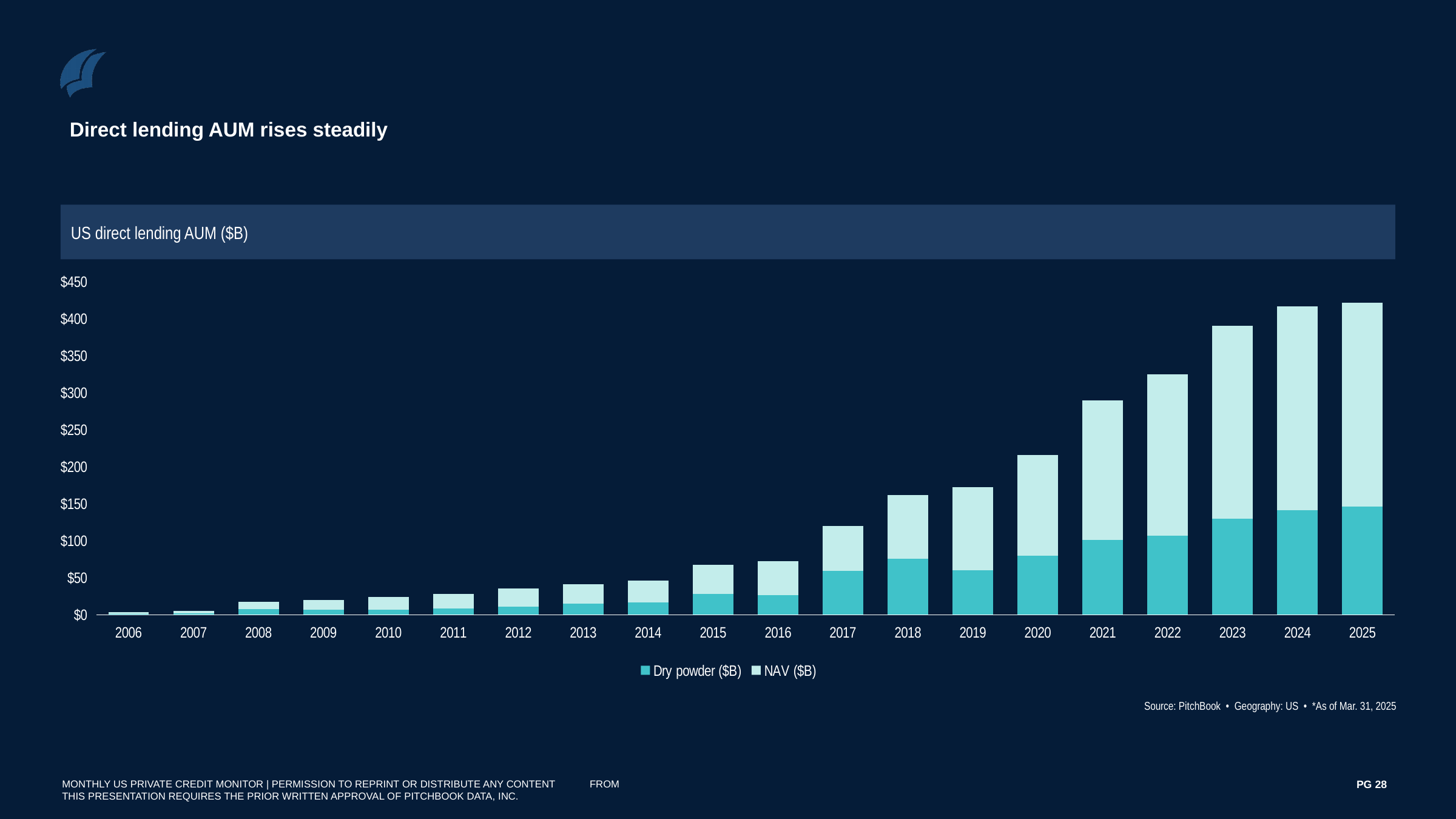
Is the total AUM for 2025 greater or less than $400? greater What are the two series named in the legend? Dry powder ($B) and NAV ($B) Which year has the highest total US direct lending AUM? 2025 How many series does the legend list? 2 Is the total AUM for 2020 greater or less than $200? greater Which year has a larger total AUM, 2019 or 2020? 2020 What is the title of the chart? US direct lending AUM ($B) Which year has the lowest total US direct lending AUM? 2006 How many years are shown on the x axis of the chart? 20 Do total AUM values generally rise or fall from 2006 to 2025? rise What kind of chart is shown on the slide? Stacked bar chart Is the total AUM for 2023 greater or less than $400? less